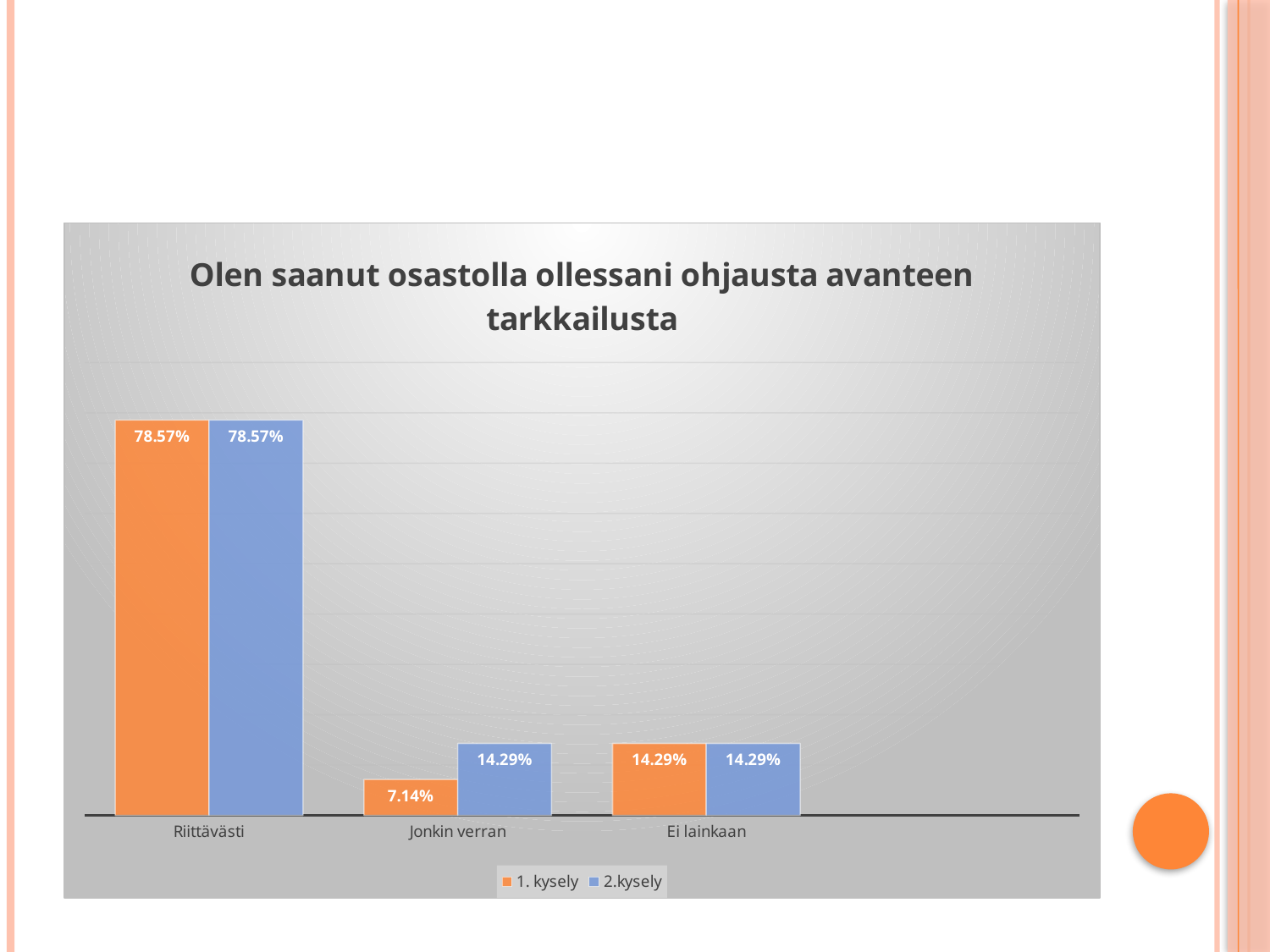
Which category has the lowest value in the 1. kysely series? Jonkin verran What kind of chart is shown on the slide? Bar chart What is the value for Ei lainkaan in the 2.kysely series? 14.29% Which category has the highest value in the 1. kysely series? Riittävästi How many categories are shown on the x axis? 3 What is the value for Jonkin verran in the 1. kysely series? 7.14% What is the value for Jonkin verran in the 2.kysely series? 14.29% How many series does the legend list? 2 What is the value for Riittävästi in the 1. kysely series? 78.57% What is the difference between the 2.kysely and 1. kysely values for Jonkin verran? 7.15% What is the difference between the Riittävästi and Ei lainkaan values in the 2.kysely series? 64.28% Which is larger for Jonkin verran: the 1. kysely value or the 2.kysely value? 2.kysely